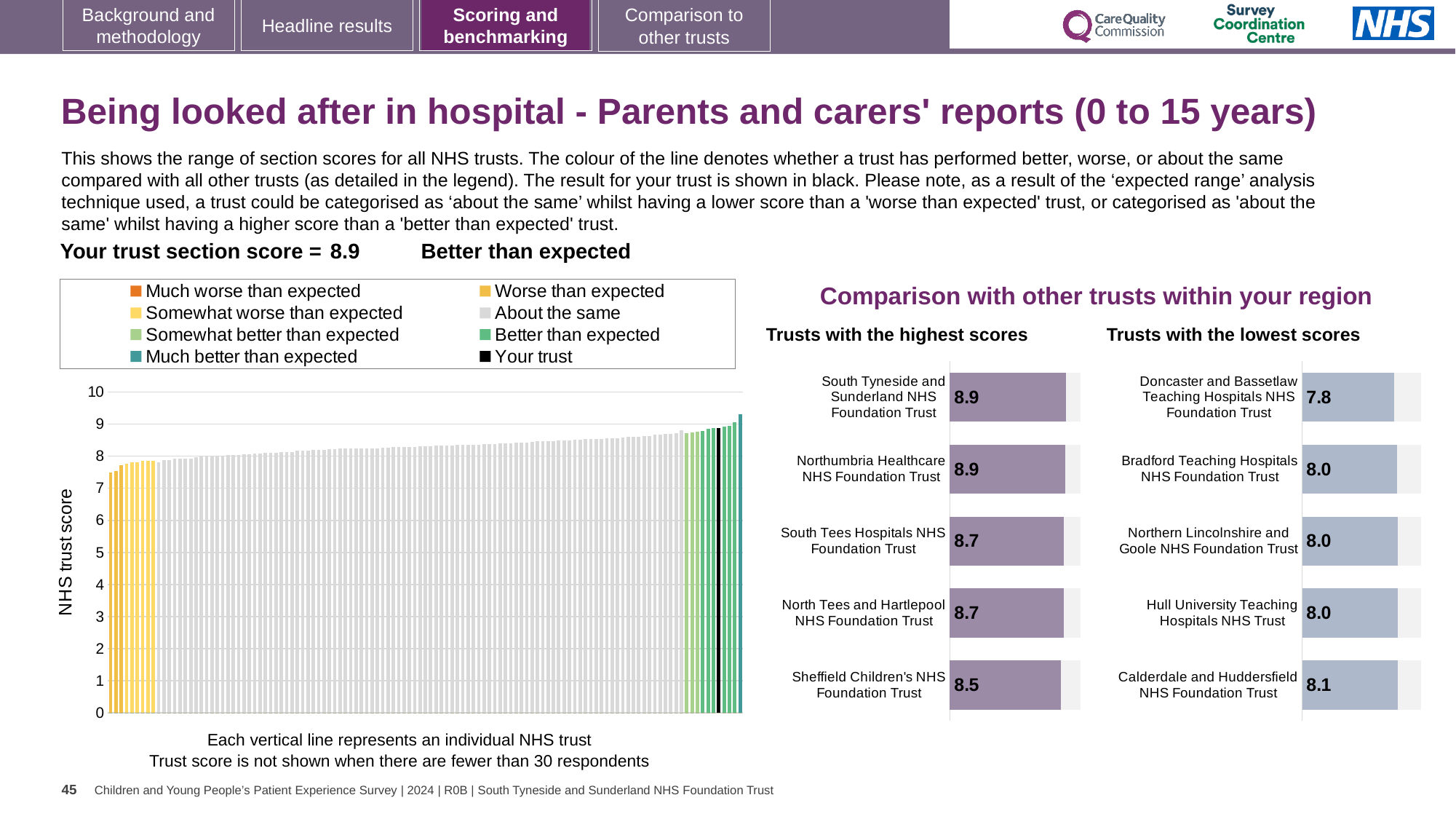
How many entries does the legend above the large chart on the left list? 8 In the 'Trusts with the lowest scores' chart, which trust has the highest score? Calderdale and Huddersfield NHS Foundation Trust In the large chart on the left showing NHS trust scores, is the value of the leftmost bar greater or less than 8? less What kind of chart is the large chart on the left showing NHS trust scores? Bar chart In the 'Trusts with the highest scores' chart, what is the difference between the scores of South Tyneside and Sunderland NHS Foundation Trust and Sheffield Children's NHS Foundation Trust? 0.4 In the 'Trusts with the highest scores' chart, what is the score for South Tees Hospitals NHS Foundation Trust? 8.7 In the large chart on the left showing NHS trust scores, do the values rise or fall from left to right? Rise How many trusts are shown in the 'Trusts with the highest scores' chart? 5 In the 'Trusts with the lowest scores' chart, what is the difference between the scores of Calderdale and Huddersfield NHS Foundation Trust and Doncaster and Bassetlaw Teaching Hospitals NHS Foundation Trust? 0.3 In the 'Trusts with the lowest scores' chart, what is the score for Doncaster and Bassetlaw Teaching Hospitals NHS Foundation Trust? 7.8 In the 'Trusts with the highest scores' chart, which has the larger score: Northumbria Healthcare NHS Foundation Trust or North Tees and Hartlepool NHS Foundation Trust? Northumbria Healthcare NHS Foundation Trust In the 'Trusts with the lowest scores' chart, which trust has the lowest score? Doncaster and Bassetlaw Teaching Hospitals NHS Foundation Trust